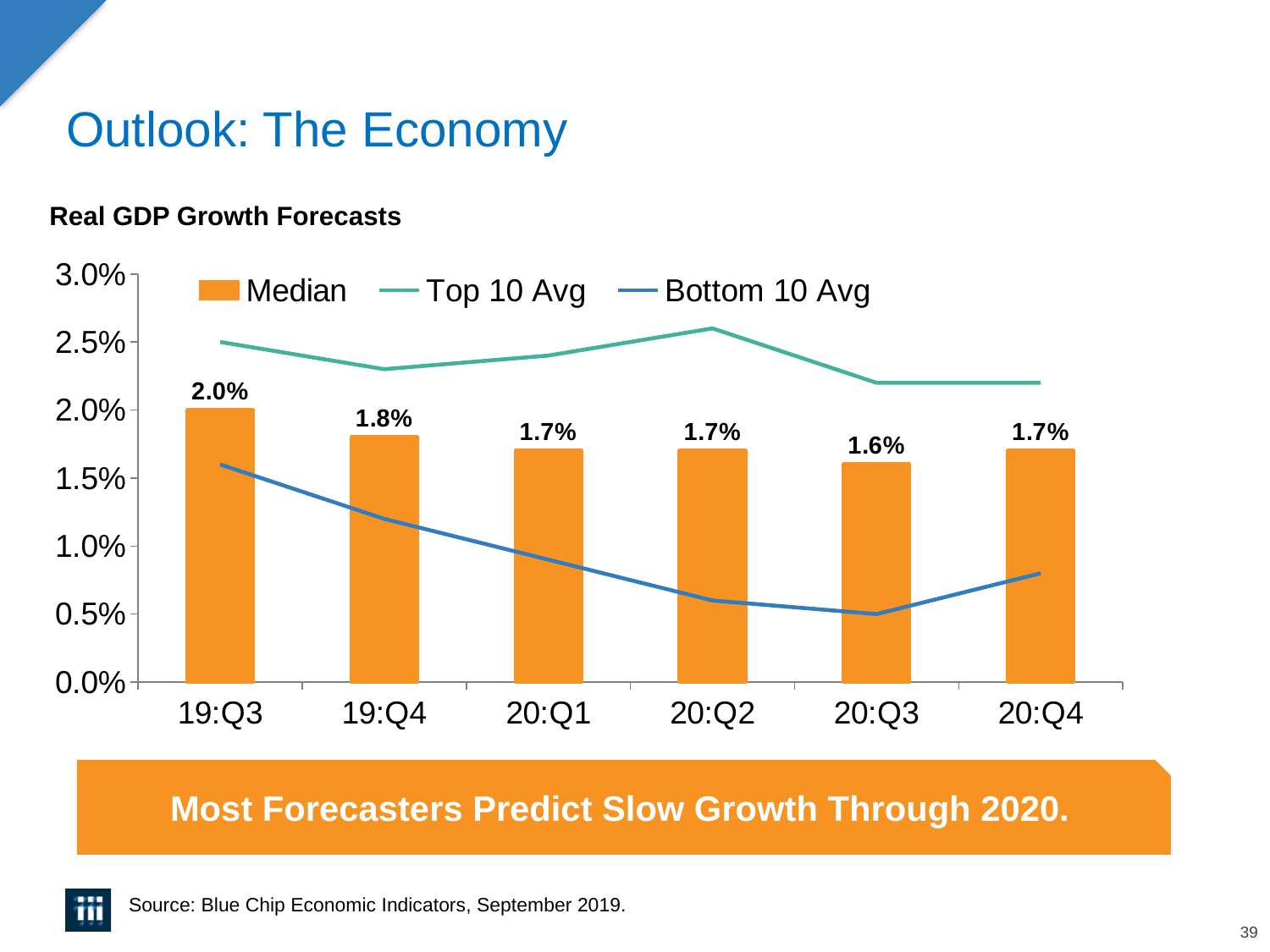
Is the Top 10 Avg value for 20:Q2 greater or less than 2.5%? greater Is the Bottom 10 Avg value for 20:Q3 greater or less than 1.0%? less Does the Bottom 10 Avg line rise or fall from 19:Q3 to 20:Q3? fall What is the Median real GDP growth forecast for 19:Q3? 2.0% How many series does the legend list? 3 What is the difference between the Median forecast for 19:Q3 and 19:Q4? 0.2% Is the Median forecast for 19:Q4 larger or smaller than the Median forecast for 20:Q3? larger How many quarters are shown on the x axis? 6 What is the Median forecast value for 20:Q4? 1.7% Which quarter has the highest Median forecast? 19:Q3 What is the Median forecast value for 20:Q3? 1.6% Which quarter has the lowest Median forecast? 20:Q3